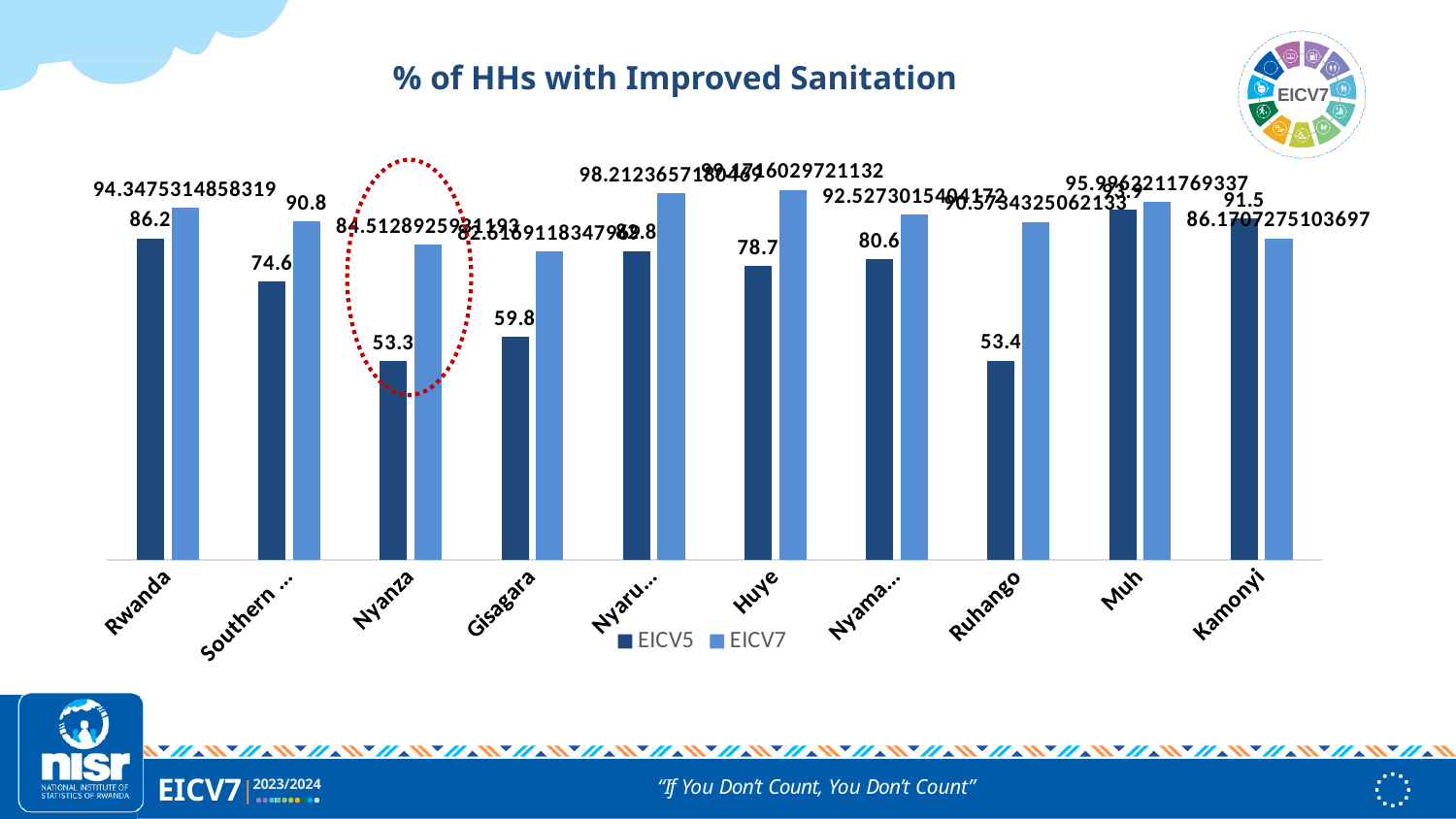
What is the EICV5 value for Kamonyi? 91.5 How many series does the legend list? 2 What is the EICV5 value for Nyanza? 53.3 What is the EICV7 value for Southern ...? 90.8 What is the EICV7 value for Rwanda? 94.3475314858319 Which category has the highest EICV5 value? Muh What is the EICV5 value for Ruhango? 53.4 For Kamonyi, which is larger: the EICV5 value or the EICV7 value? EICV5 Which category is highlighted with a red dotted circle? Nyanza What is the EICV5 value for Rwanda? 86.2 How many categories are shown on the x axis? 10 What is the difference between the EICV7 and EICV5 values for Southern ...? 16.2